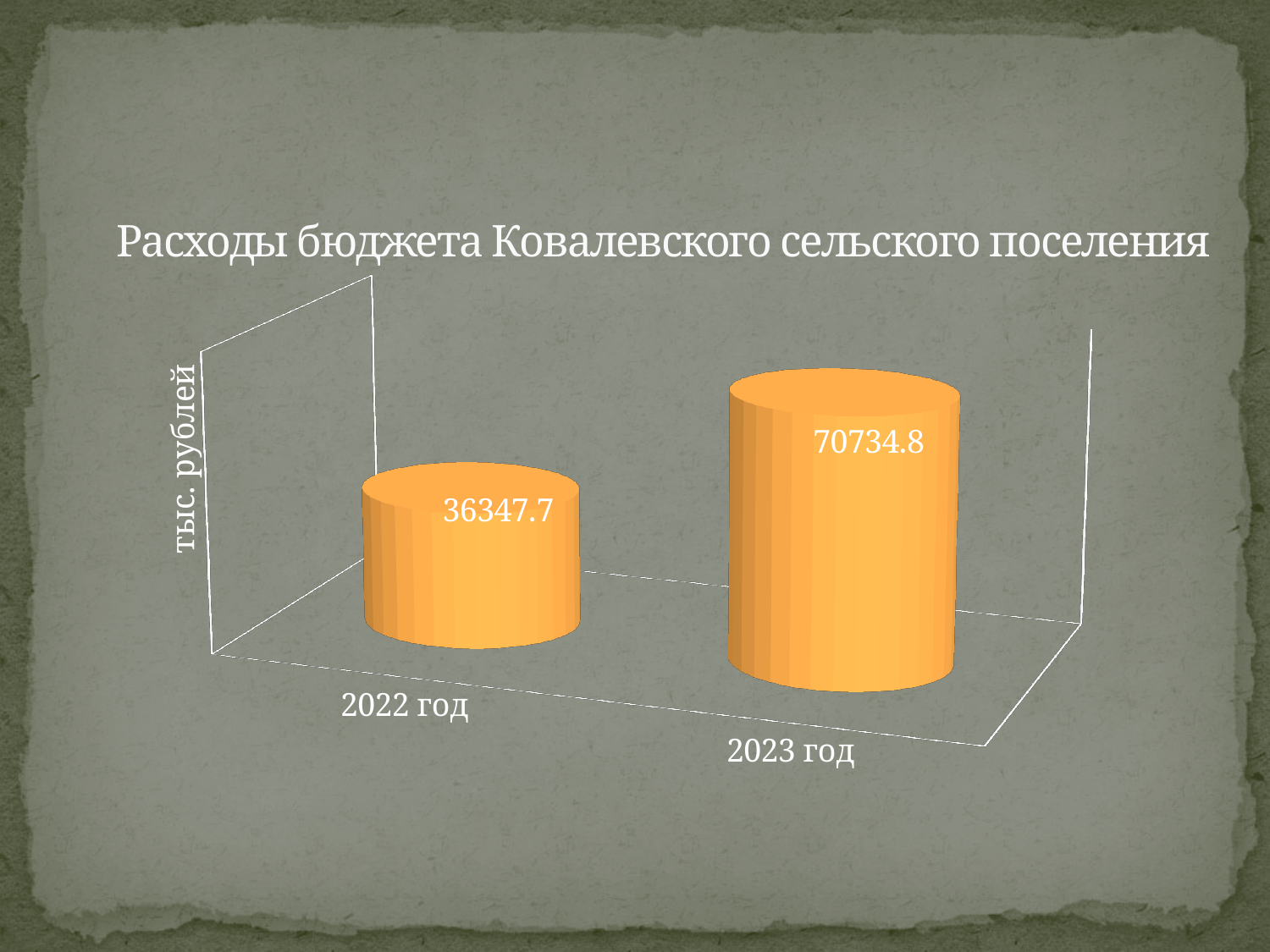
Which is larger, the value for 2022 год or the value for 2023 год? 2023 год Do the values rise or fall from 2022 год to 2023 год? Rise Which year has the highest value? 2023 год What is the title of the chart? Расходы бюджета Ковалевского сельского поселения Which year has the lowest value? 2022 год How many categories are shown on the chart? 2 What is the value for 2022 год? 36347.7 What is the label on the vertical axis of the chart? тыс. рублей What is the difference between the values for 2023 год and 2022 год? 34387.1 What is the value for 2023 год? 70734.8 What kind of chart is shown on the slide? Bar chart